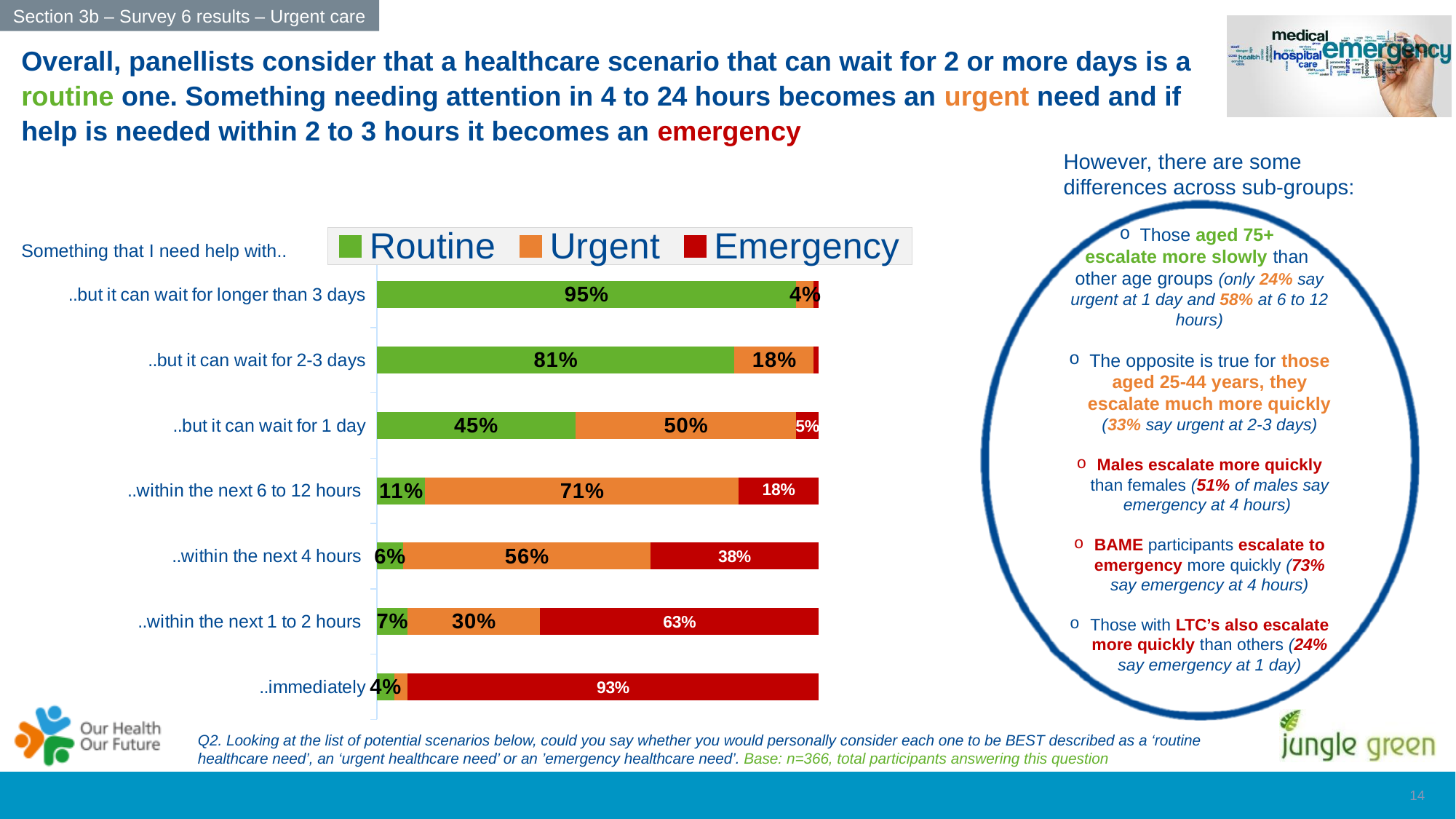
What is the Urgent value for '..but it can wait for 1 day'? 50% How many scenario categories are plotted in the chart? 7 Which scenario has the highest Urgent value? ..within the next 6 to 12 hours What type of chart is shown on the slide? Stacked bar chart What is the Emergency value for '..within the next 4 hours'? 38% Which series is shown in red in the chart legend? Emergency Which is larger: the Emergency value for '..within the next 1 to 2 hours' or for '..within the next 4 hours'? ..within the next 1 to 2 hours What is the difference between the Routine values for '..but it can wait for longer than 3 days' and '..but it can wait for 2-3 days'? 14% Which scenario has the lowest Routine value among those with a printed Routine label? ..immediately What is the Emergency value for '..immediately'? 93% What percentage of panellists consider something that can wait for longer than 3 days to be Routine? 95% How many series does the chart legend list? 3